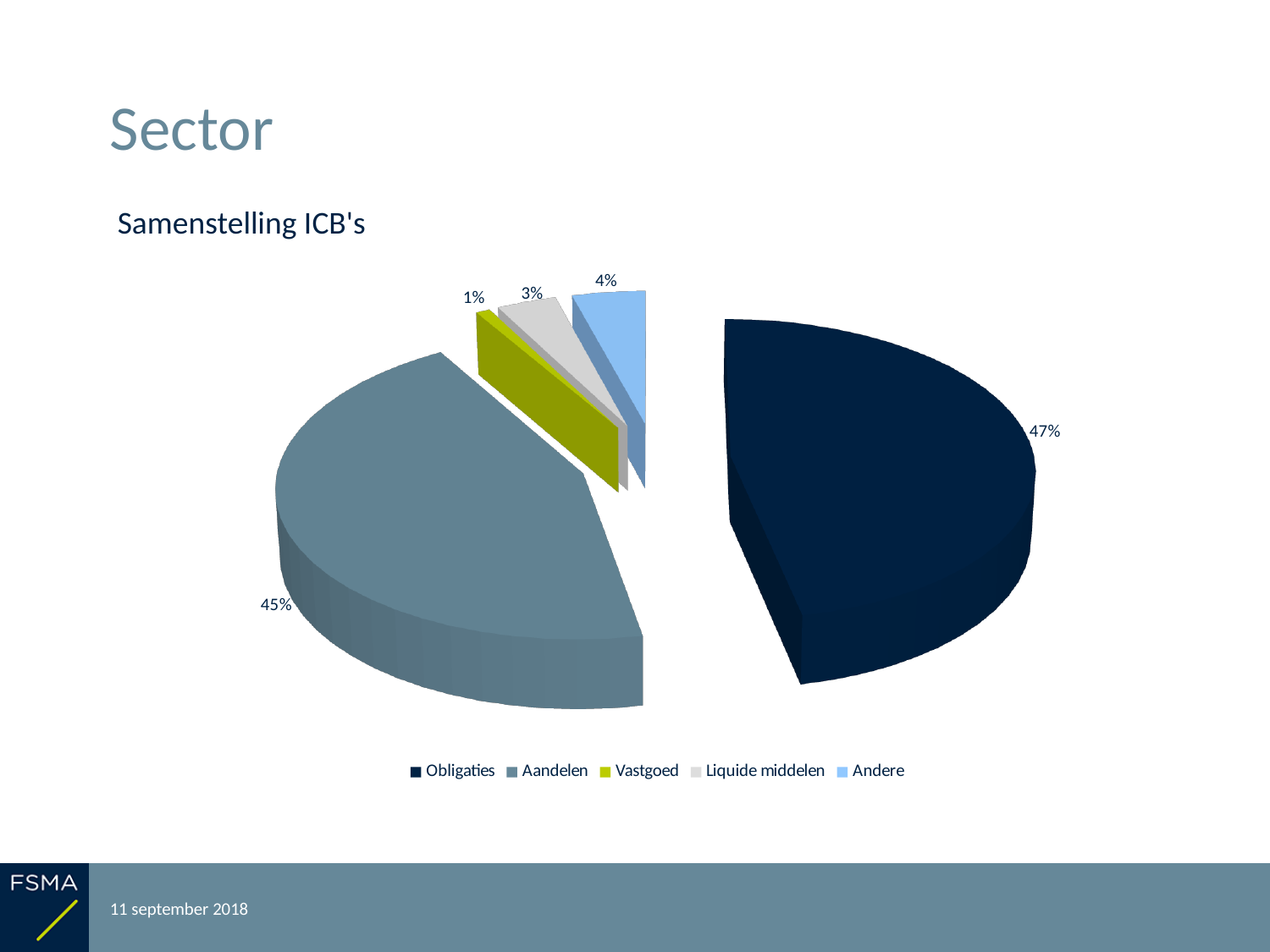
Which category has the smallest share of the pie? Vastgoed What percentage of the pie is Liquide middelen? 3% What kind of chart is shown on the slide? pie chart What percentage of the pie is Vastgoed? 1% What is the difference in percentage points between Obligaties and Aandelen? 2 Which is larger, the share for Andere or the share for Liquide middelen? Andere Which category has the largest share of the pie? Obligaties What percentage of the pie is Obligaties? 47% What percentage of the pie is Aandelen? 45% How many categories does the legend list? 5 What percentage of the pie is Andere? 4% What is the title of the chart? Samenstelling ICB's